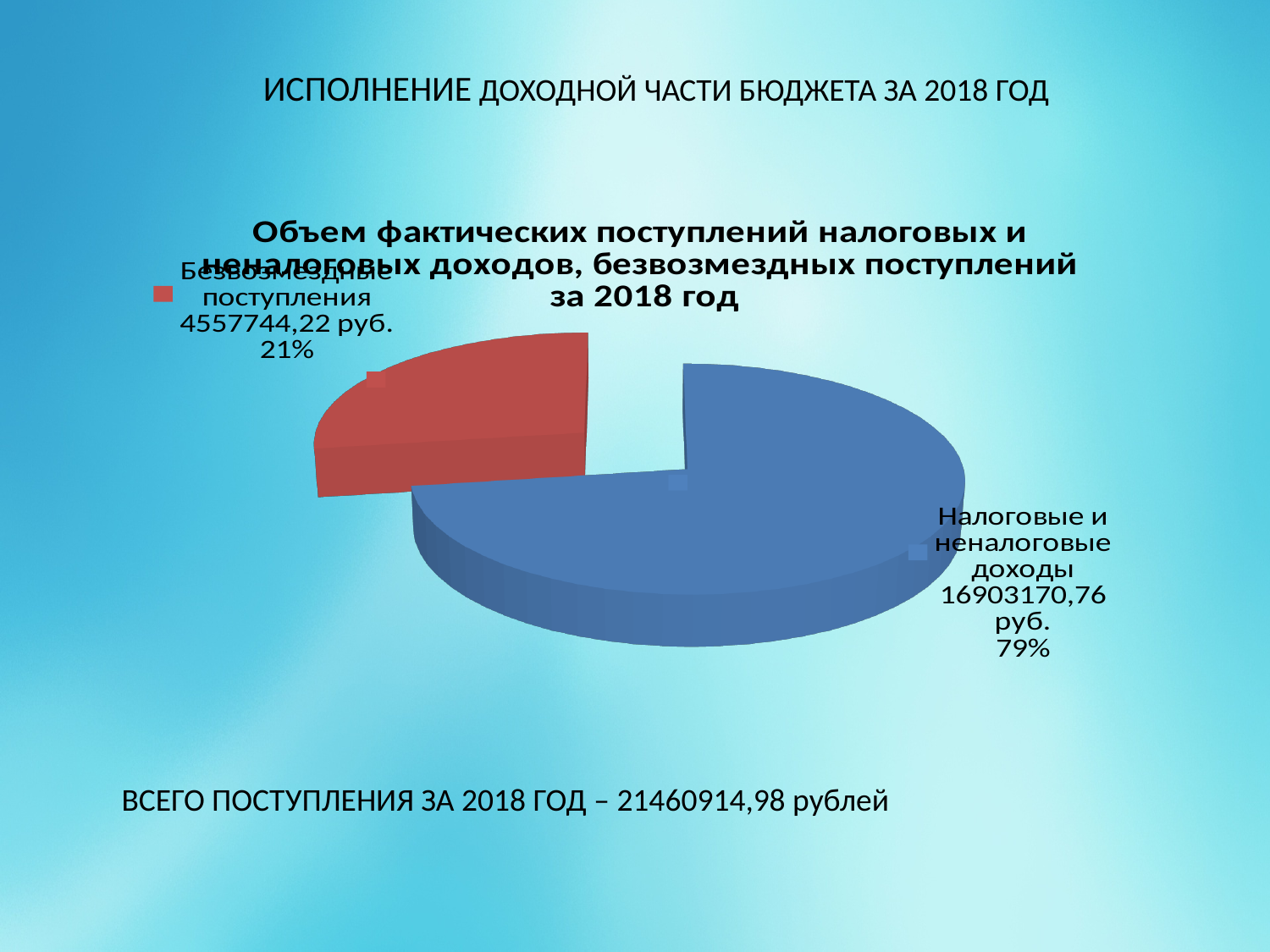
What is the value shown for Безвозмездные поступления? 4557744,22 руб. Which category has the smallest slice of the pie? Безвозмездные поступления What is the title of the pie chart? Объем фактических поступлений налоговых и неналоговых доходов, безвозмездных поступлений за 2018 год Which is larger: Налоговые и неналоговые доходы or Безвозмездные поступления? Налоговые и неналоговые доходы What kind of chart is shown on the slide? Pie chart What share of the pie does Налоговые и неналоговые доходы represent? 79% Which category has the largest slice of the pie? Налоговые и неналоговые доходы What is the value shown for Налоговые и неналоговые доходы? 16903170,76 руб. What share of the pie does Безвозмездные поступления represent? 21% What colour is the slice for Безвозмездные поступления? Red How many slices does the pie chart have? 2 What is the difference in percentage points between the share of Налоговые и неналоговые доходы and the share of Безвозмездные поступления? 58 percentage points